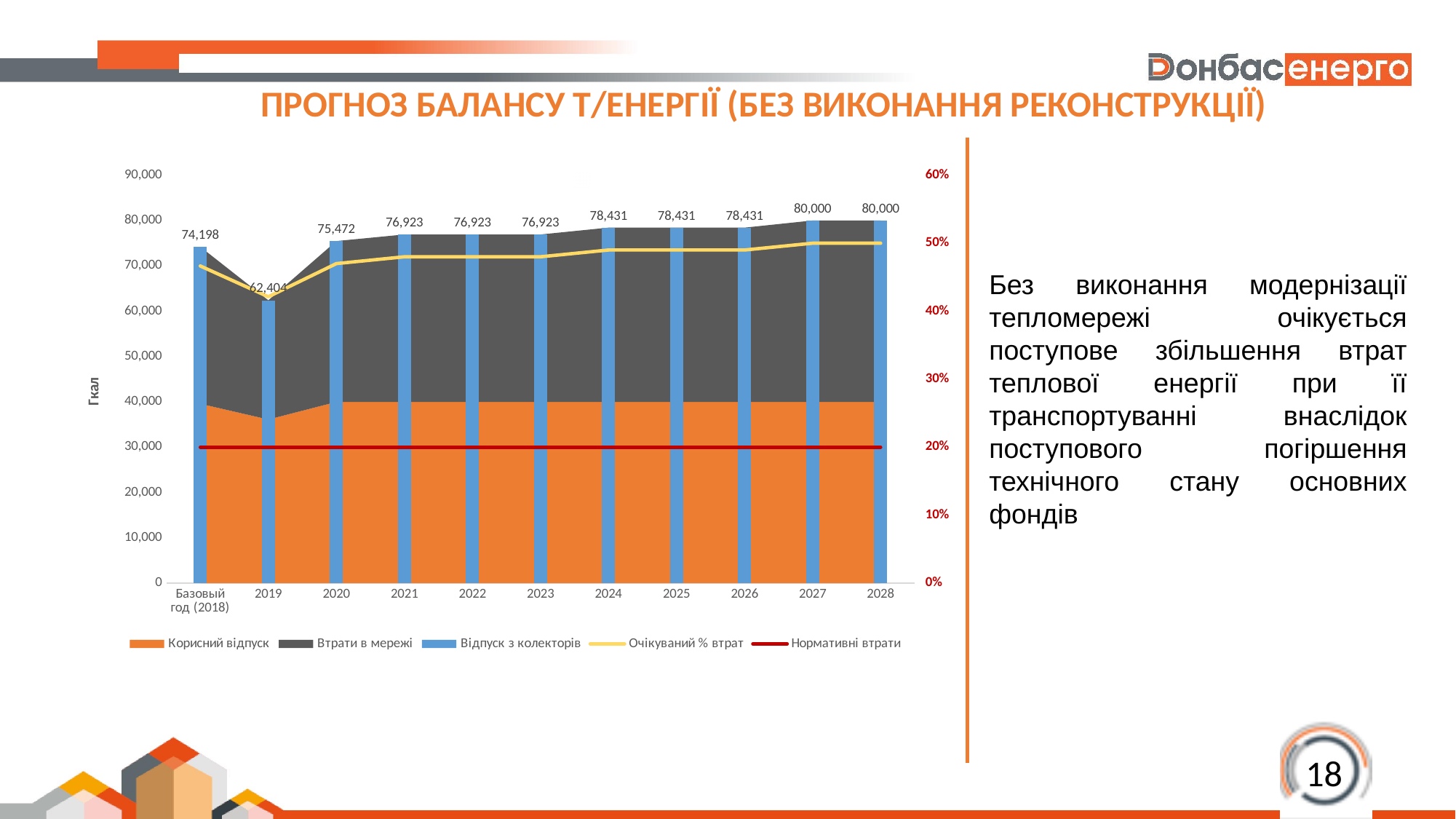
Which is larger, the Відпуск з колекторів value for 2020 or for 2024? 2024 Do the Відпуск з колекторів bars rise or fall from 2020 to 2028? rise Is the Нормативні втрати line greater or less than 30% on the right axis? less What is the value of Відпуск з колекторів for 2024? 78,431 What is the difference between the Відпуск з колекторів values for 2028 and Базовый год (2018)? 5,802 Which year has the lowest Відпуск з колекторів bar? 2019 What is the value of Відпуск з колекторів for 2028? 80,000 How many years (categories) are shown on the x axis? 11 What is the difference between the Відпуск з колекторів values for 2020 and 2019? 13,068 Is the Очікуваний % втрат value for 2028 greater or less than 40%? greater What is the value of Відпуск з колекторів for 2019? 62,404 How many series does the legend list? 5